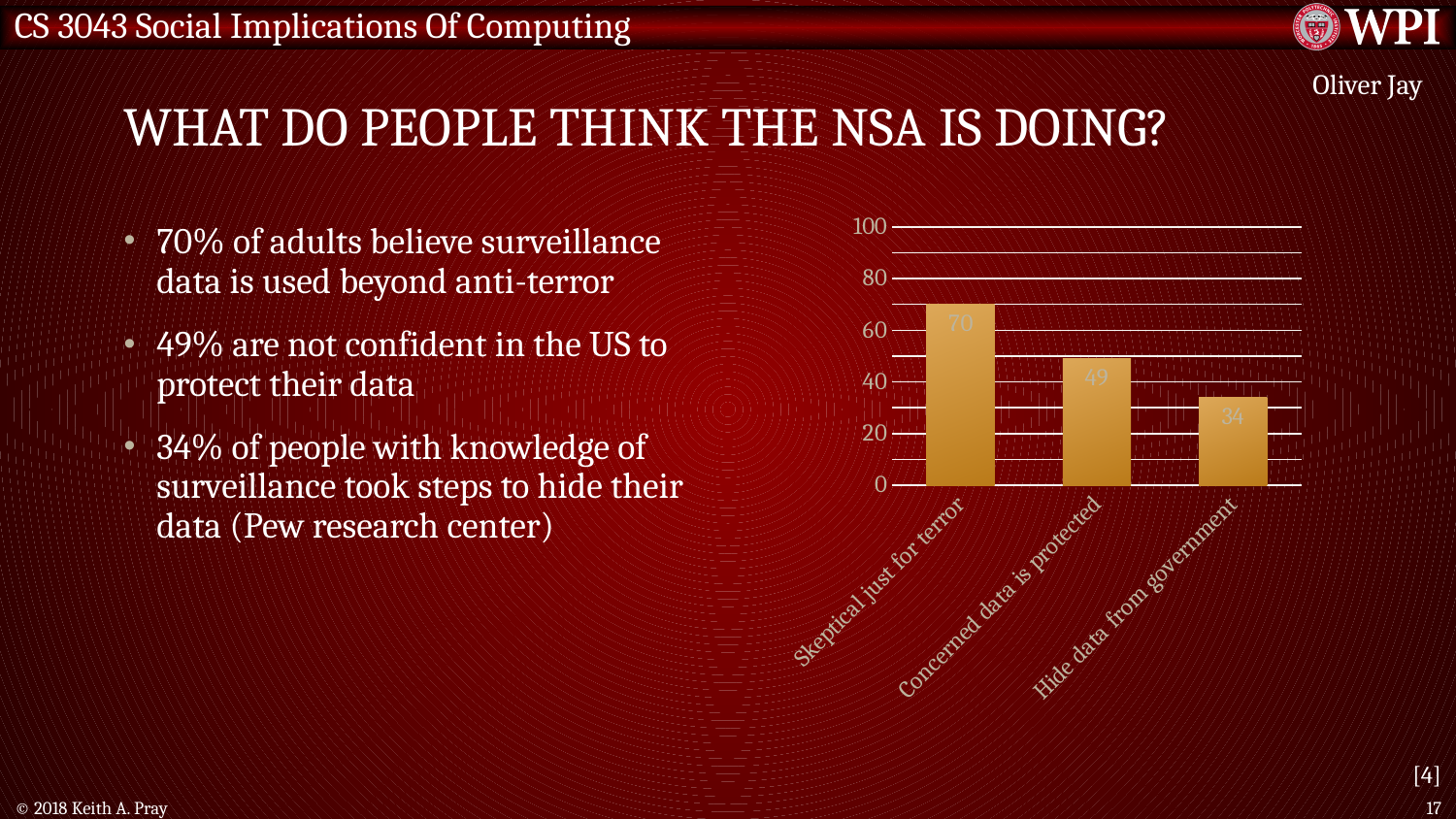
Which is larger, the value for "Concerned data is protected" or the value for "Hide data from government"? Concerned data is protected What is the difference between the values for "Skeptical just for terror" and "Hide data from government"? 36 Do the values rise or fall from left to right across the categories? fall Is the value for "Skeptical just for terror" greater or less than 60? greater What is the value for "Concerned data is protected"? 49 What is the difference between the values for "Concerned data is protected" and "Hide data from government"? 15 How many categories are shown in the chart? 3 What kind of chart is shown on the slide? bar chart Which category has the lowest value? Hide data from government Which category has the highest value? Skeptical just for terror What is the value for "Hide data from government"? 34 What is the value for "Skeptical just for terror"? 70